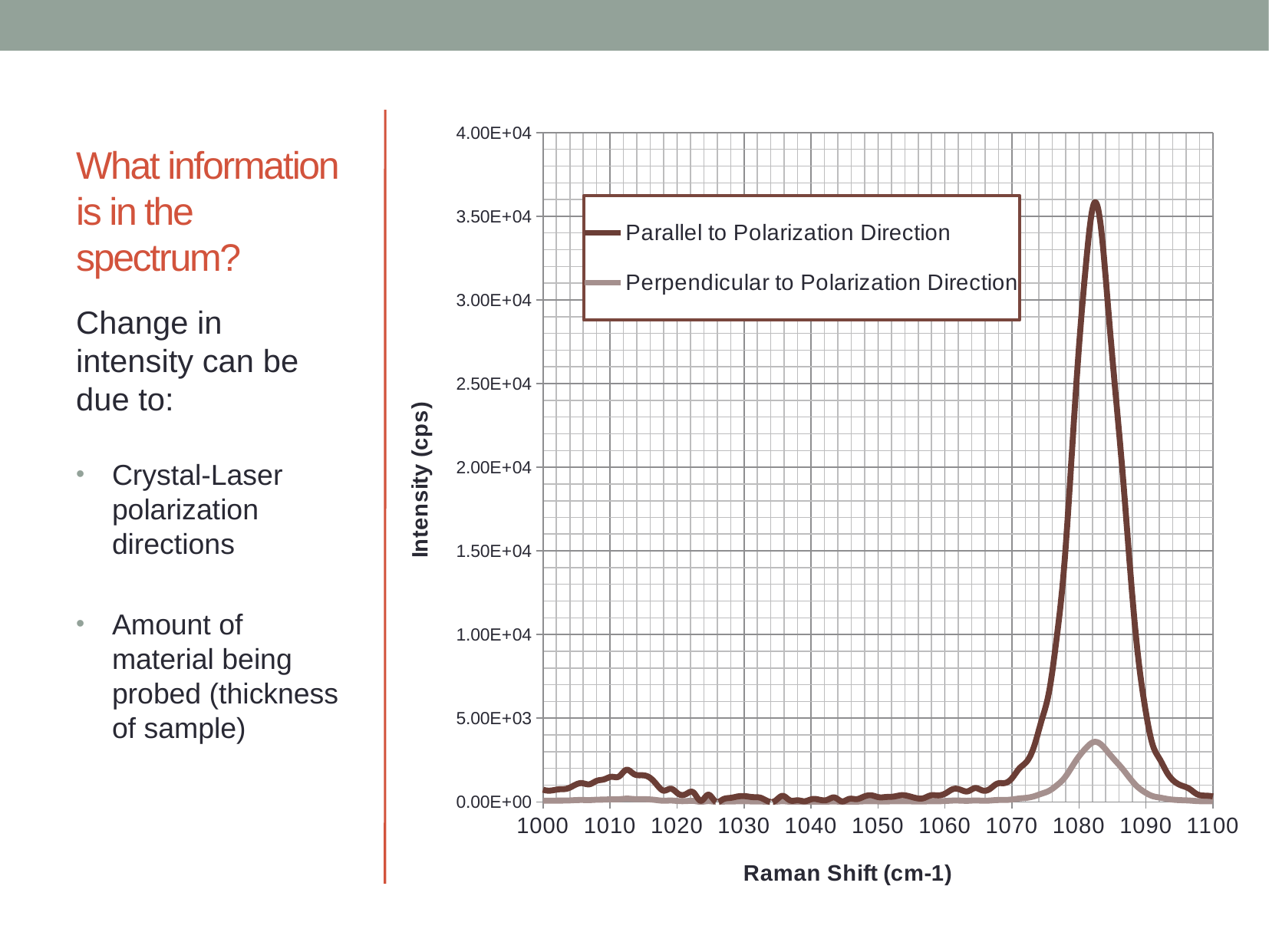
Does the Parallel to Polarization Direction line rise or fall between 1070 and 1080 on the x axis? rise What is the label of the y axis? Intensity (cps) What are the two series named in the legend? Parallel to Polarization Direction; Perpendicular to Polarization Direction Which series reaches the higher peak intensity, Parallel to Polarization Direction or Perpendicular to Polarization Direction? Parallel to Polarization Direction Is the peak value of the Perpendicular to Polarization Direction series greater or less than 5.00E+03? less What is the highest value shown on the y axis? 4.00E+04 How many series does the legend list? 2 How many tick labels are shown on the x axis? 11 Is the peak value of the Parallel to Polarization Direction series greater or less than 3.00E+04? greater Does the Parallel to Polarization Direction line rise or fall between 1090 and 1100 on the x axis? fall What kind of chart is shown on the slide? line chart Is the value of the Parallel to Polarization Direction series at 1050 greater or less than 5.00E+03? less